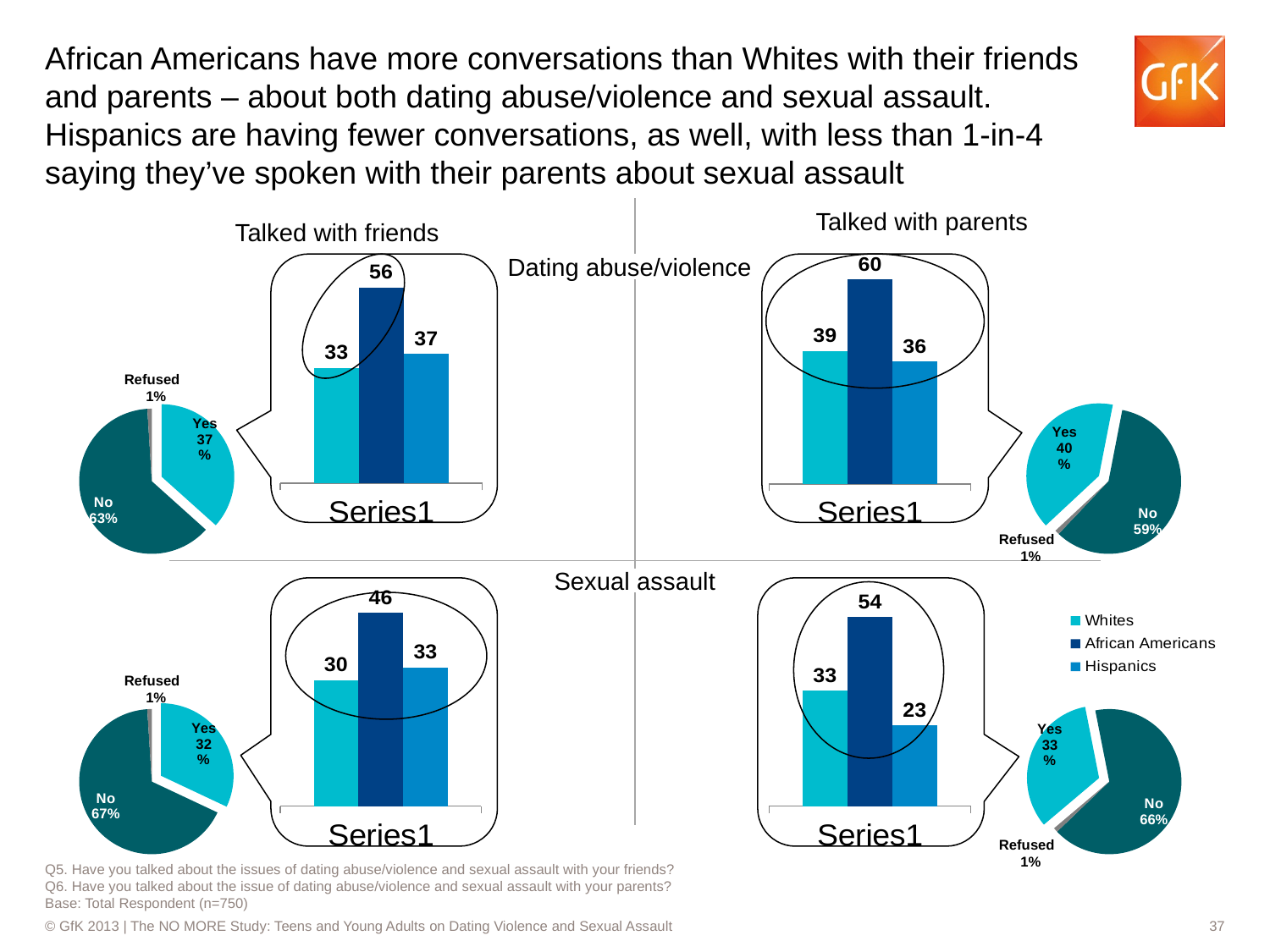
In the 'Talked with parents' bar chart for dating abuse/violence (top right), what is the difference between the values for African Americans and Hispanics? 24 In the pie chart at the top right (talked with parents about dating abuse/violence), what share of respondents answered 'Yes'? 40% What kind of chart is the 'Talked with friends' chart for sexual assault (bottom left, inside the callout)? bar chart In the 'Talked with friends' bar chart for dating abuse/violence (top left), what is the value for African Americans? 56 In the 'Talked with parents' bar chart for sexual assault (bottom right), which group has the lowest value? Hispanics In the 'Talked with friends' bar chart for sexual assault (bottom left), what is the difference between the values for African Americans and Whites? 16 In the 'Talked with friends' bar chart for sexual assault (bottom left), which group has the highest value? African Americans In the 'Talked with parents' bar chart for dating abuse/violence (top right), what is the value for Whites? 39 In the 'Talked with friends' bar chart for dating abuse/violence (top left), which is larger: the value for Whites or the value for Hispanics? Hispanics In the 'Talked with parents' bar chart for sexual assault (bottom right), what is the value for Hispanics? 23 In the pie chart at the bottom left (talked with friends about sexual assault), what share of respondents answered 'No'? 67% How many series does the legend list for the bar charts? 3